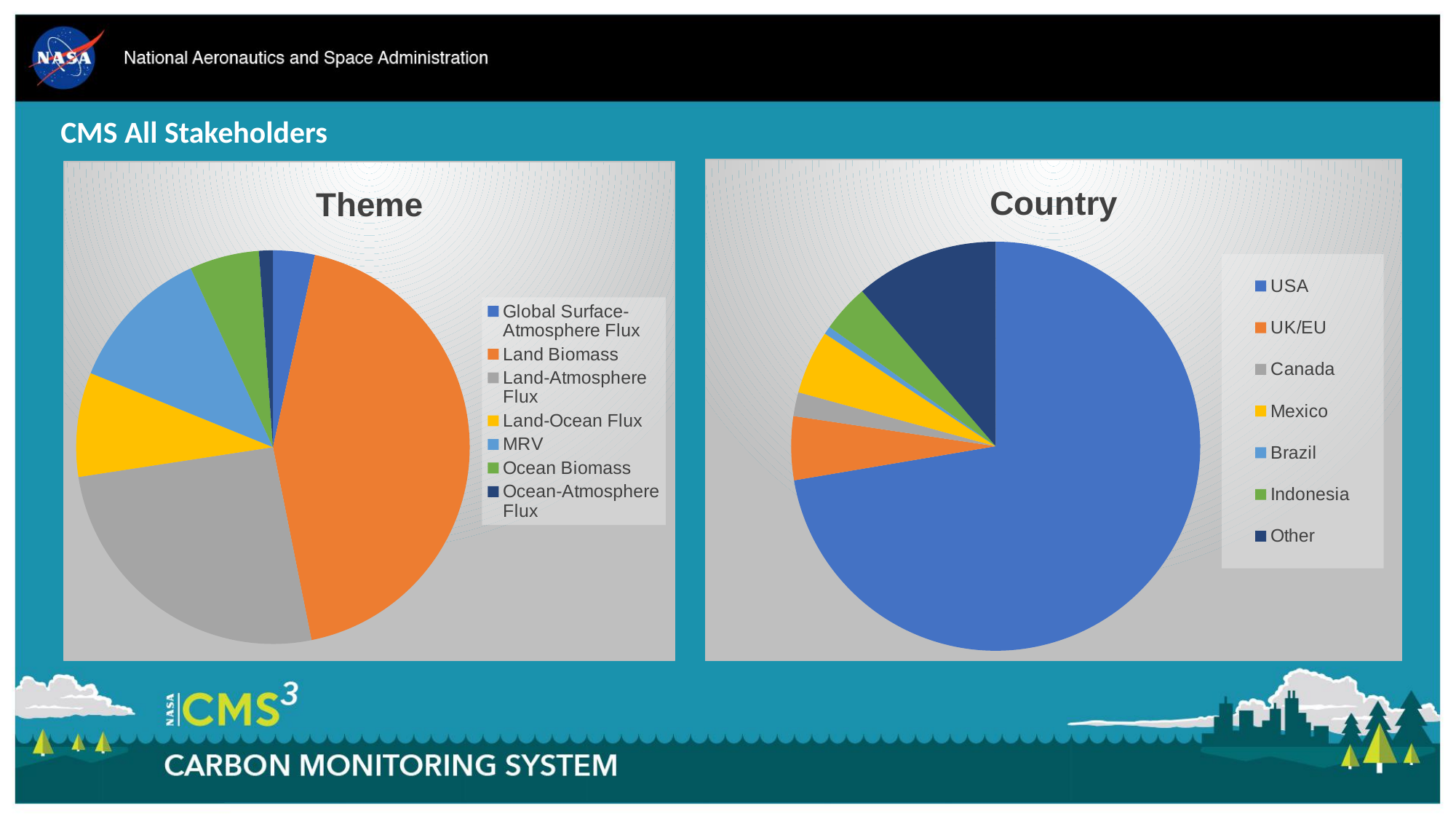
What kind of chart is the Country chart? pie chart What kind of chart is the Theme chart? pie chart In the Theme chart, which category has the smallest slice? Ocean-Atmosphere Flux In the Country chart, which slice is larger: Other or Indonesia? Other In the Country chart, which slice is larger: UK/EU or Canada? UK/EU In the Theme chart, how many categories does the legend list? 7 In the Country chart, how many categories does the legend list? 7 In the Country chart, which country has the smallest slice? Brazil In the Country chart, which country has the largest slice? USA What is the title of the chart on the right side of the slide? Country In the Theme chart, which category has the largest slice? Land Biomass In the Theme chart, which slice is larger: Land-Atmosphere Flux or Land-Ocean Flux? Land-Atmosphere Flux